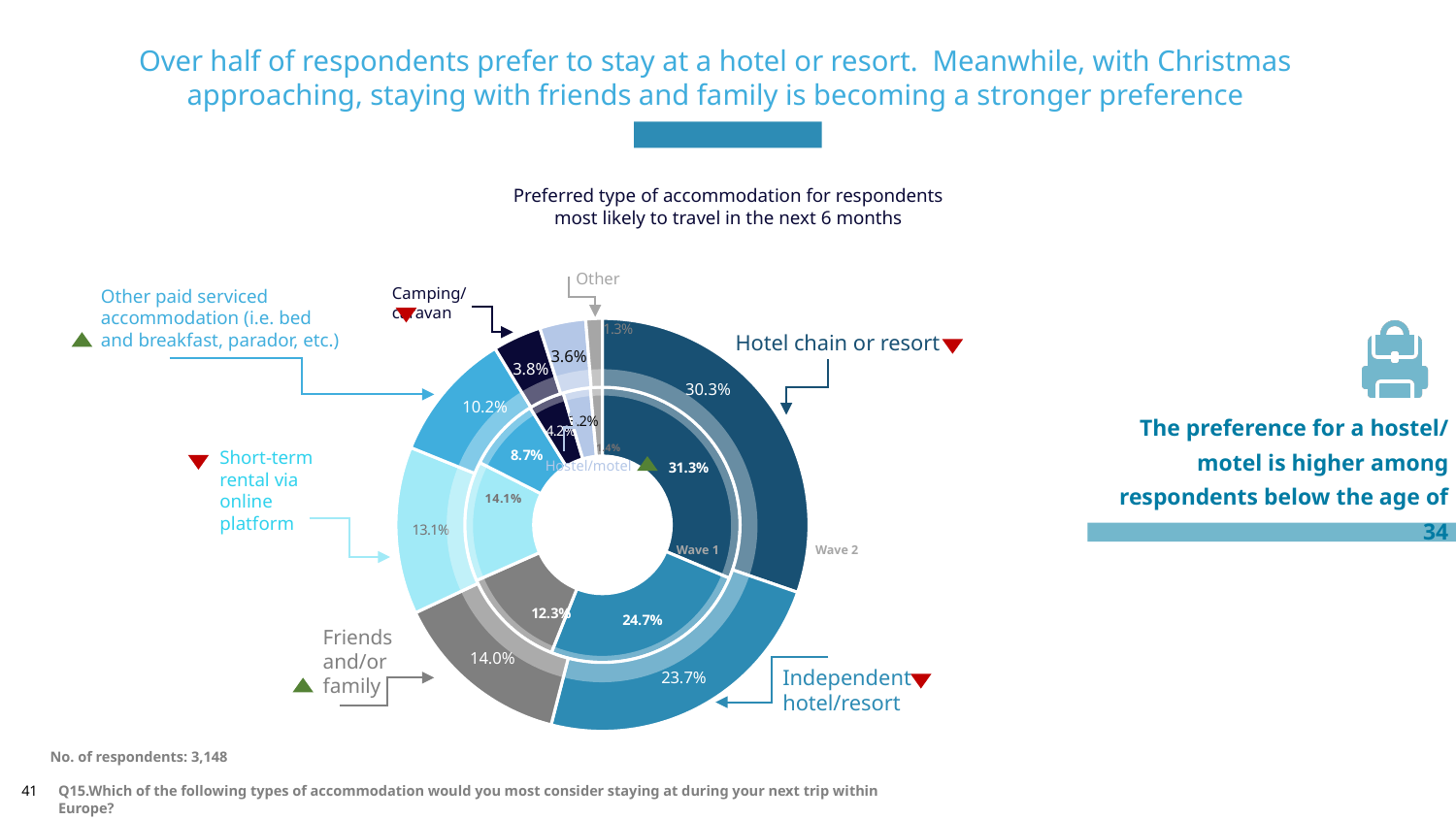
Which accommodation type has the smallest share in Wave 2? Other Which is larger for Independent hotel/resort: the Wave 1 value or the Wave 2 value? Wave 1 (24.7%) What is the Wave 2 value for Other paid serviced accommodation? 10.2% How many waves (series) does the chart show? 2 What is the Wave 2 value for Independent hotel/resort? 23.7% What kind of chart is shown on the slide? Doughnut (pie) chart What is the Wave 2 value for Hotel chain or resort? 30.3% Which accommodation type has the largest share in Wave 2? Hotel chain or resort What is the Wave 2 value for Short-term rental via online platform? 13.1% What is the Wave 1 value for Friends and/or family? 12.3% What is the difference between the Wave 1 and Wave 2 values for Friends and/or family? 1.7 percentage points What is the Wave 1 value for Hotel chain or resort? 31.3%